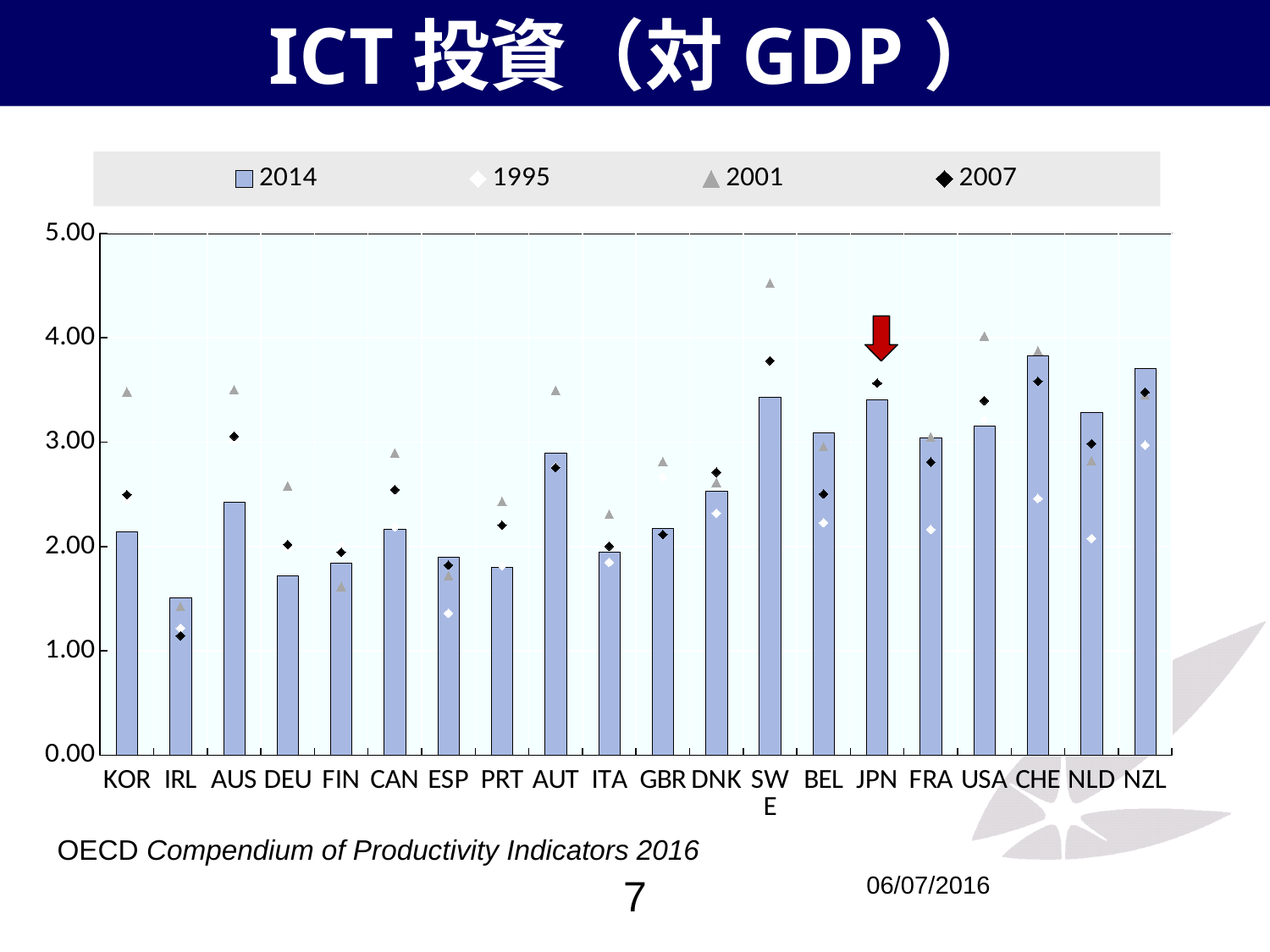
Is the 2001 value for SWE greater or less than 4.00? greater Which country does the red arrow above the chart point to? JPN What kind of chart is shown on the slide? bar chart Which has the larger 2014 value, AUS or DEU? AUS How many countries are shown on the x axis of the chart? 20 Is the 2014 value for DEU greater or less than 2.00? less Is the 2014 value for SWE greater or less than 3.00? greater How many series does the chart's legend list? 4 Which country has the highest 2001 marker? SWE Which country has the lowest 2014 bar? IRL Which has the larger 2014 value, SWE or BEL? SWE